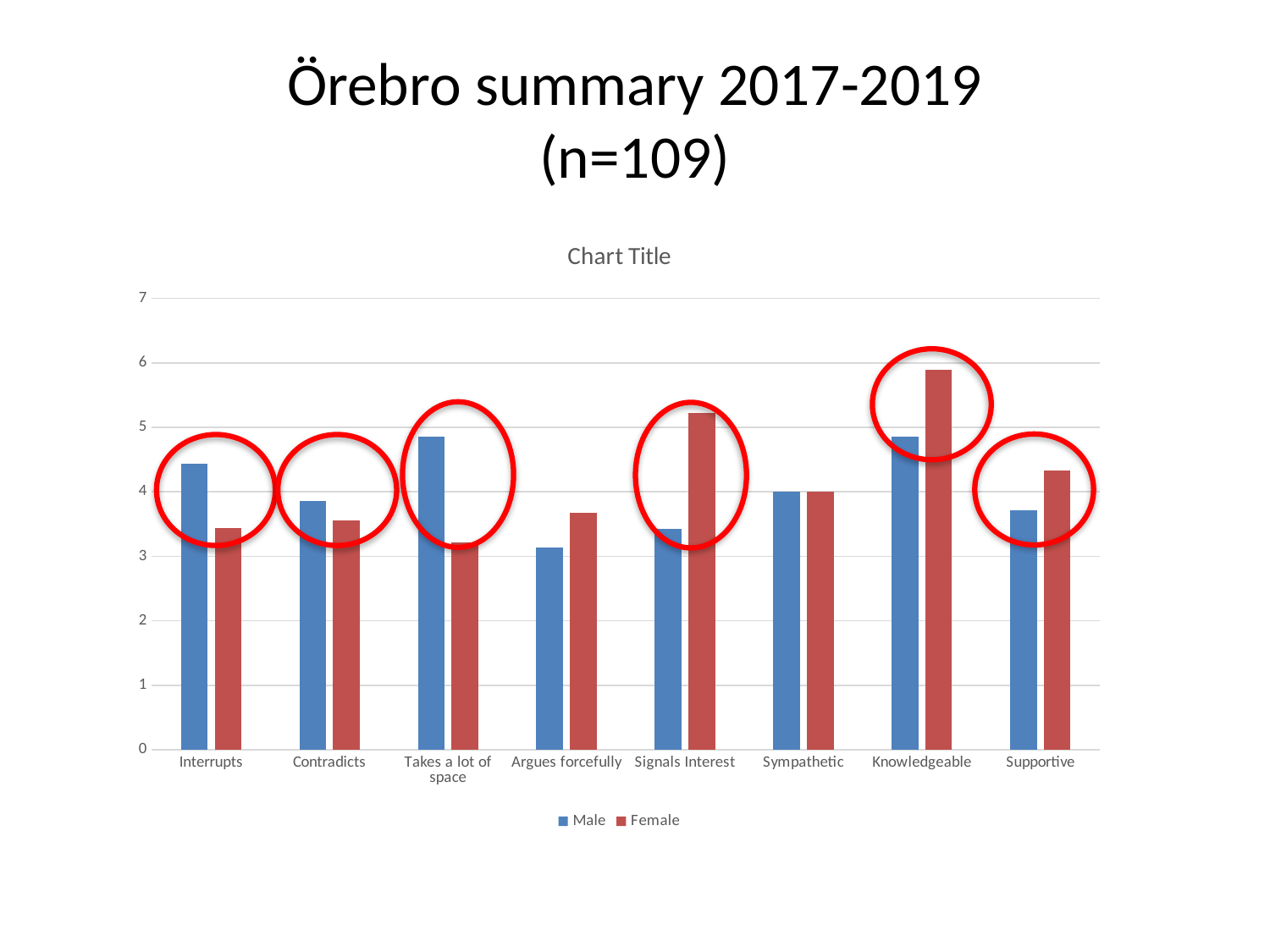
Which category has the highest Female value? Knowledgeable What kind of chart is shown on the slide? bar chart For Signals Interest, which is larger, the Male value or the Female value? Female Is the Female value for Takes a lot of space greater or less than 4? less Which category has the lowest Female value? Takes a lot of space What are the two series named in the chart's legend? Male and Female How many categories are shown on the x axis of the chart? 8 How many series does the chart's legend list? 2 Is the Female value for Knowledgeable greater or less than 5? greater Is the Male value for Argues forcefully greater or less than 4? less For Interrupts, which is larger, the Male value or the Female value? Male